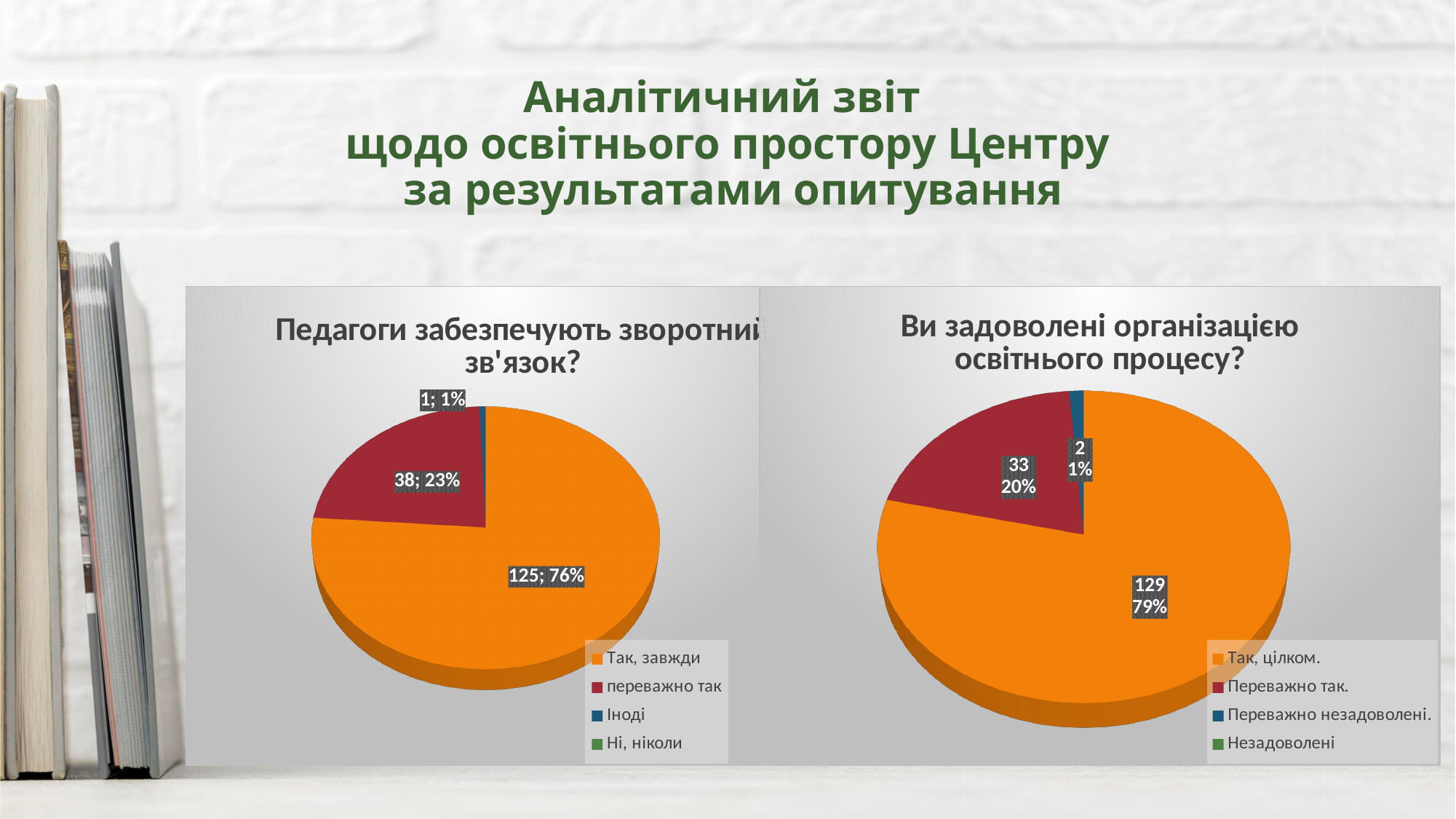
How many entries does the legend of the right chart "Ви задоволені організацією освітнього процесу?" list? 4 In the right chart "Ви задоволені організацією освітнього процесу?", how many respondents answered "Переважно незадоволені."? 2 In the left chart "Педагоги забезпечують зворотний зв'язок?", how many respondents answered "Так, завжди"? 125 In the left chart "Педагоги забезпечують зворотний зв'язок?", what percentage share does "переважно так" have? 23% What type of chart is the left chart "Педагоги забезпечують зворотний зв'язок?"? Pie chart In the right chart "Ви задоволені організацією освітнього процесу?", how many respondents answered "Так, цілком."? 129 In the left chart "Педагоги забезпечують зворотний зв'язок?", what is the difference between the counts for "Так, завжди" and "переважно так"? 87 In the left chart "Педагоги забезпечують зворотний зв'язок?", which answer has the largest slice? Так, завжди In the left chart "Педагоги забезпечують зворотний зв'язок?", how many respondents answered "Іноді"? 1 In the right chart "Ви задоволені організацією освітнього процесу?", what percentage share does "Переважно так." have? 20% In the left chart "Педагоги забезпечують зворотний зв'язок?", what colour is the "Так, завжди" slice? Orange In the right chart "Ви задоволені організацією освітнього процесу?", which is larger: the count for "Переважно так." or for "Переважно незадоволені."? Переважно так.